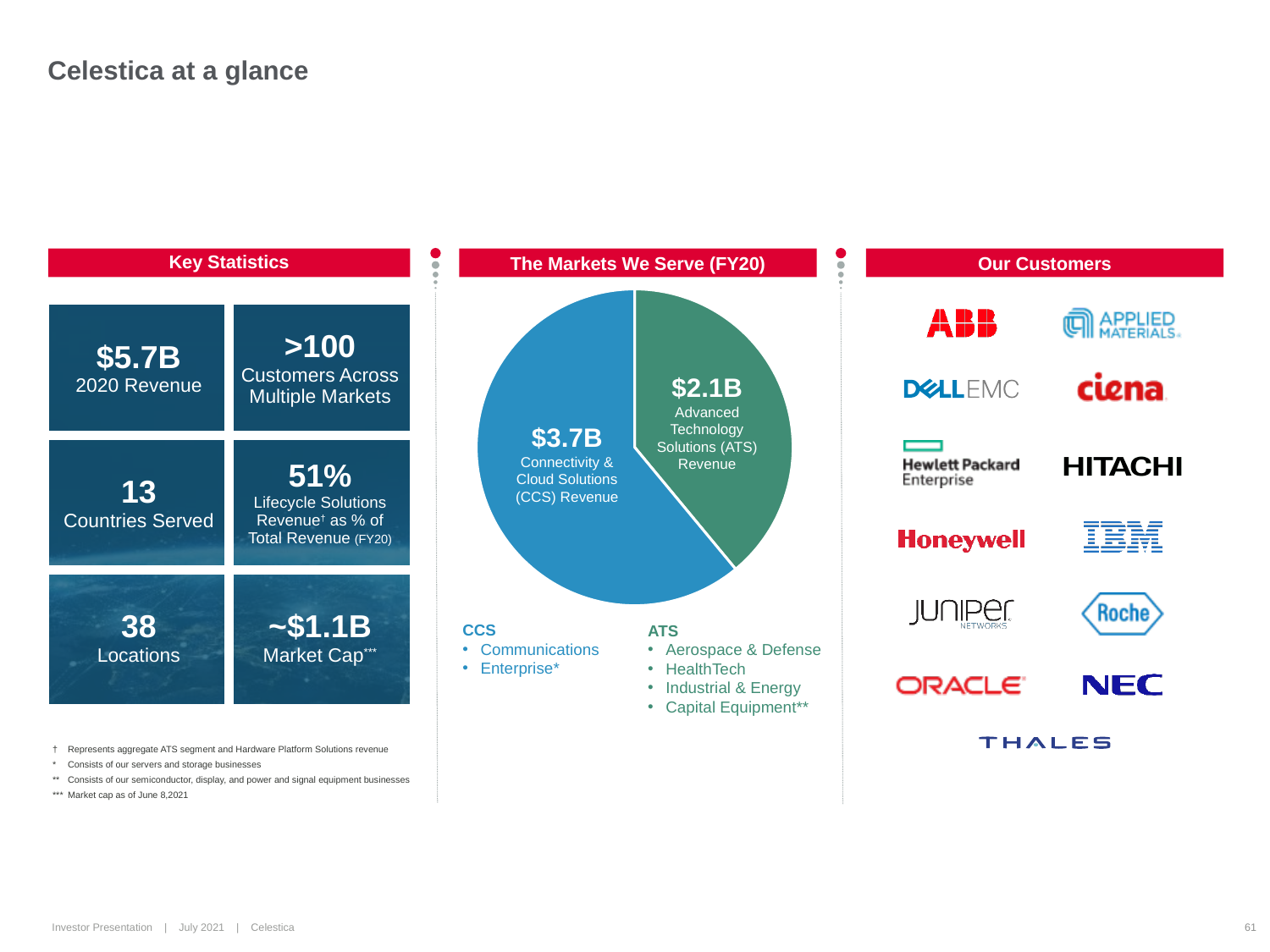
Which segment has the larger slice in the pie chart, CCS or ATS? CCS What kind of chart is shown under "The Markets We Serve (FY20)"? Pie chart What colour is the ATS Revenue slice in the pie chart? Green In the pie chart, what is the Advanced Technology Solutions (ATS) Revenue? $2.1B In the pie chart, what is the Connectivity & Cloud Solutions (CCS) Revenue? $3.7B Which segment has the largest slice in the pie chart? Connectivity & Cloud Solutions (CCS) Is the CCS Revenue slice more or less than half of the pie chart? More What is the title of the pie chart? The Markets We Serve (FY20) Which segment has the smallest slice in the pie chart? Advanced Technology Solutions (ATS) How many slices does the pie chart have? 2 How much larger is CCS Revenue than ATS Revenue in the pie chart? $1.6B